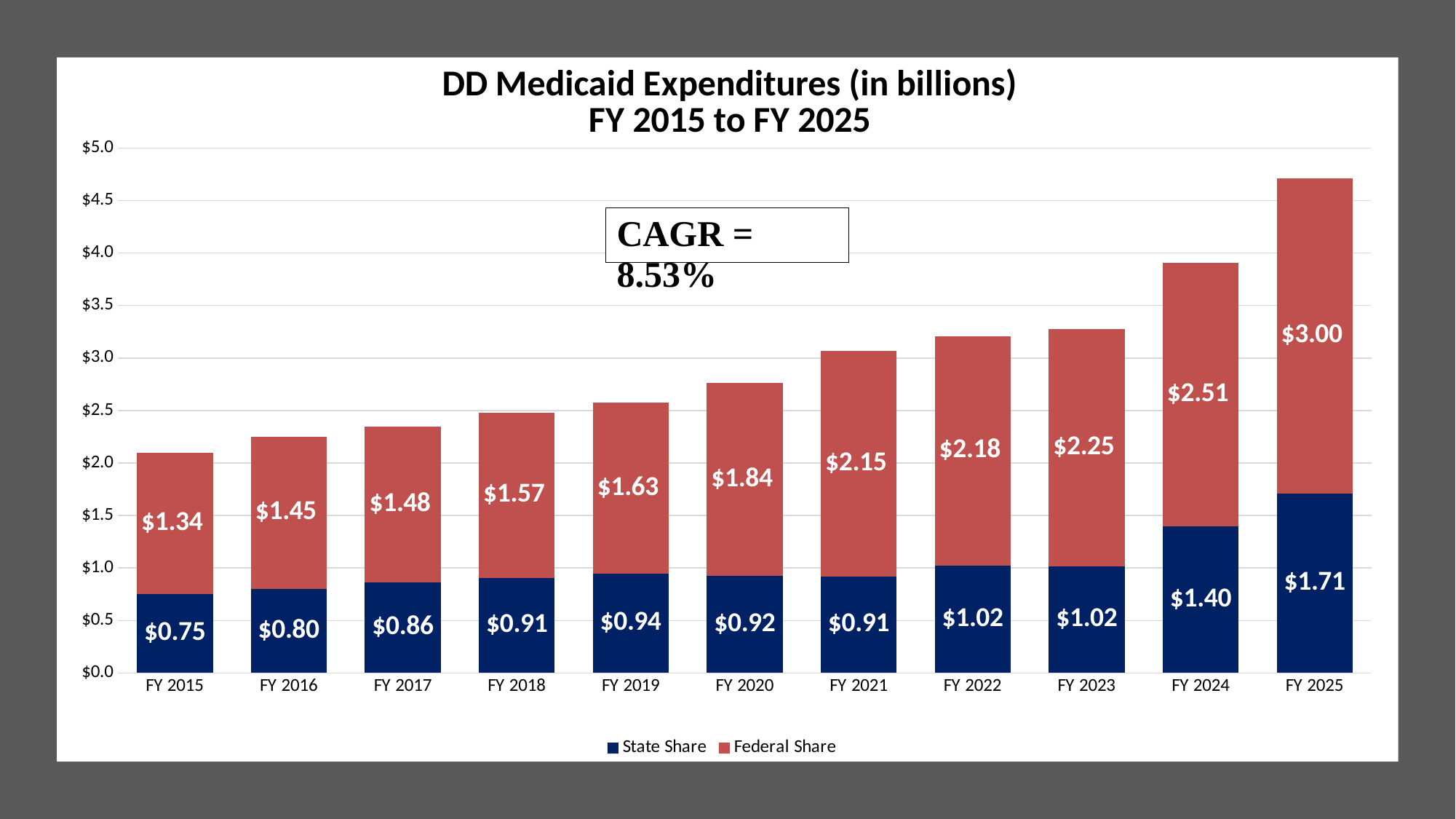
What kind of chart is shown on the slide? Stacked bar chart How many fiscal years are shown on the x axis? 11 Which fiscal year has the lowest State Share? FY 2015 What CAGR value is shown in the text box on the chart? 8.53% Which fiscal year has the highest Federal Share? FY 2025 What is the State Share value for FY 2024? $1.40 Which is larger, the State Share in FY 2019 or the State Share in FY 2020? FY 2019 What is the Federal Share value for FY 2021? $2.15 What is the total expenditure (State Share plus Federal Share) for FY 2025? $4.71 What is the State Share value for FY 2015? $0.75 What is the difference between the Federal Share in FY 2025 and the Federal Share in FY 2015? $1.66 How many series does the legend list? 2